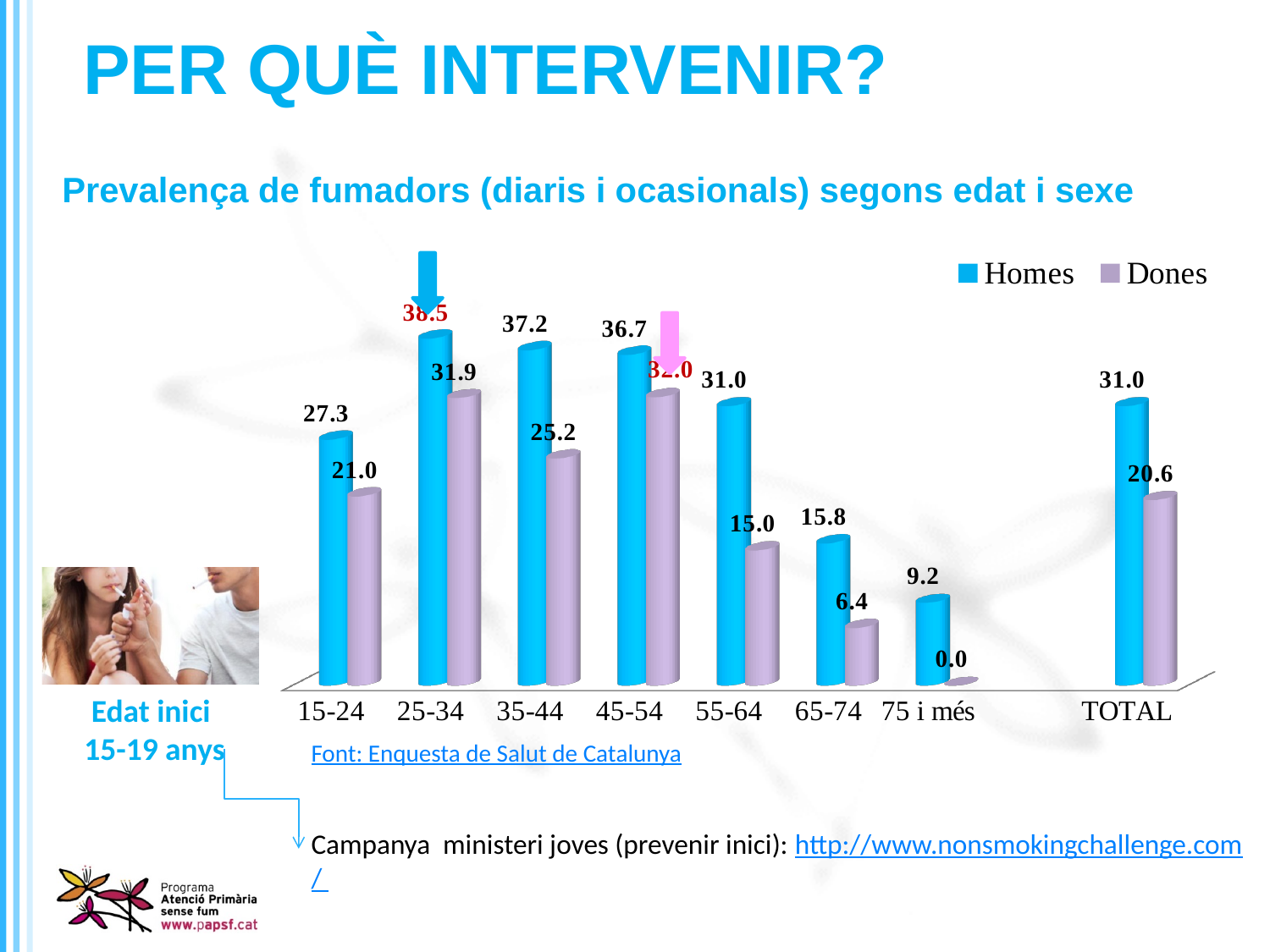
What is the value for Dones in the 35-44 age group? 25.2 What is the value for Homes in the 15-24 age group? 27.3 What is the value for Homes in the TOTAL category? 31.0 What is the difference between the Homes and Dones values in the TOTAL category? 10.4 What is the difference between the Homes and Dones values in the 65-74 age group? 9.4 Which category has the lowest value for Dones? 75 i més Which age group has the highest value for Homes? 25-34 How many categories are shown on the x axis of the chart? 8 What is the value for Dones in the 75 i més age group? 0.0 In the 55-64 age group, which series has the larger value, Homes or Dones? Homes What kind of chart is shown on the slide? Bar chart How many series does the legend list? 2